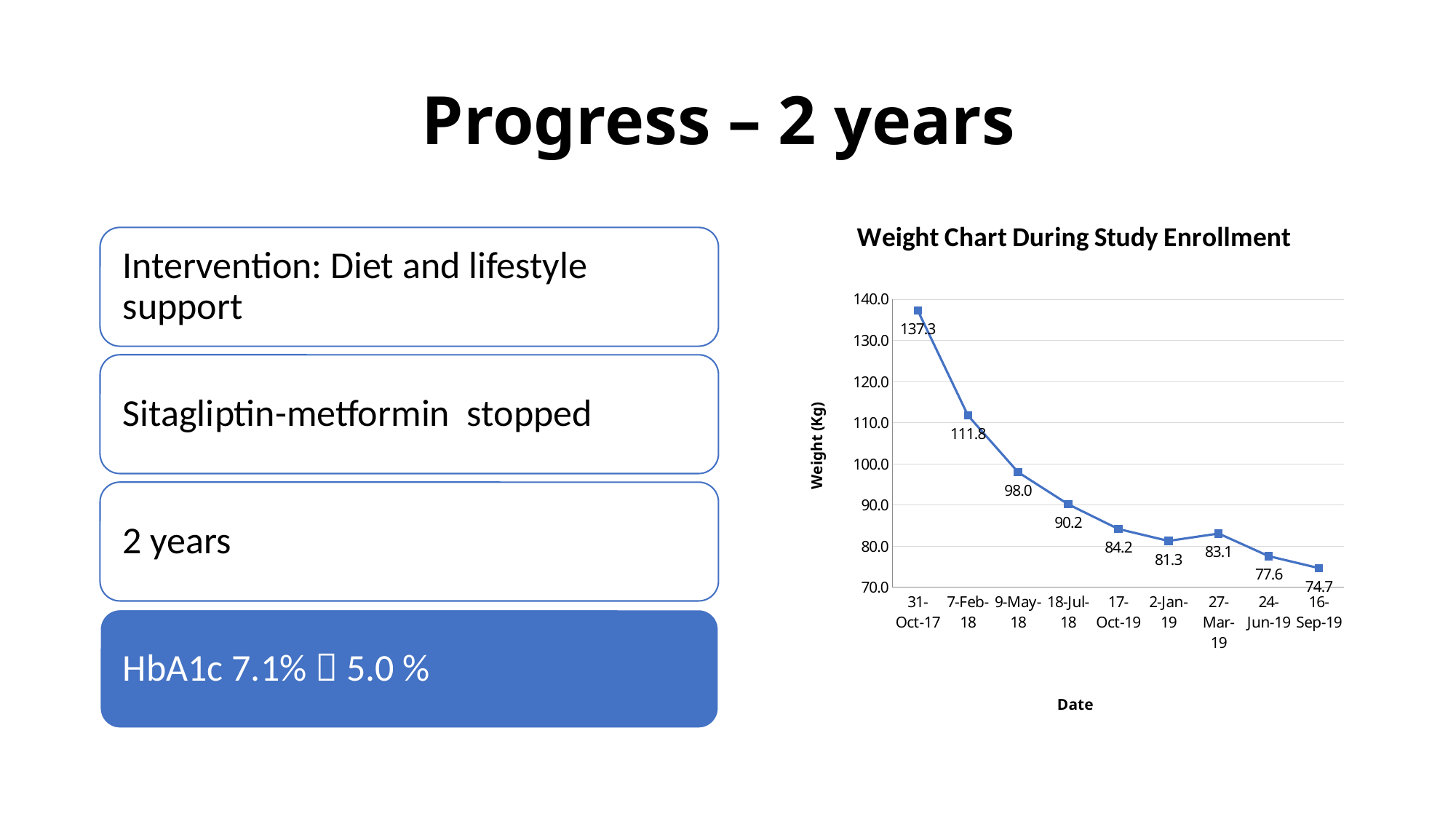
What is the weight on 31-Oct-17? 137.3 What is the title of the chart? Weight Chart During Study Enrollment What is the difference in weight between 31-Oct-17 and 16-Sep-19? 62.6 What is the weight on 2-Jan-19? 81.3 On which date is the weight lowest? 16-Sep-19 Does the weight generally rise or fall over the dates shown? Fall What kind of chart is shown? Line chart What is the weight on 16-Sep-19? 74.7 How many data points are plotted on the chart? 9 On which date is the weight highest? 31-Oct-17 Which date has the higher weight, 2-Jan-19 or 27-Mar-19? 27-Mar-19 What is the weight on 9-May-18? 98.0